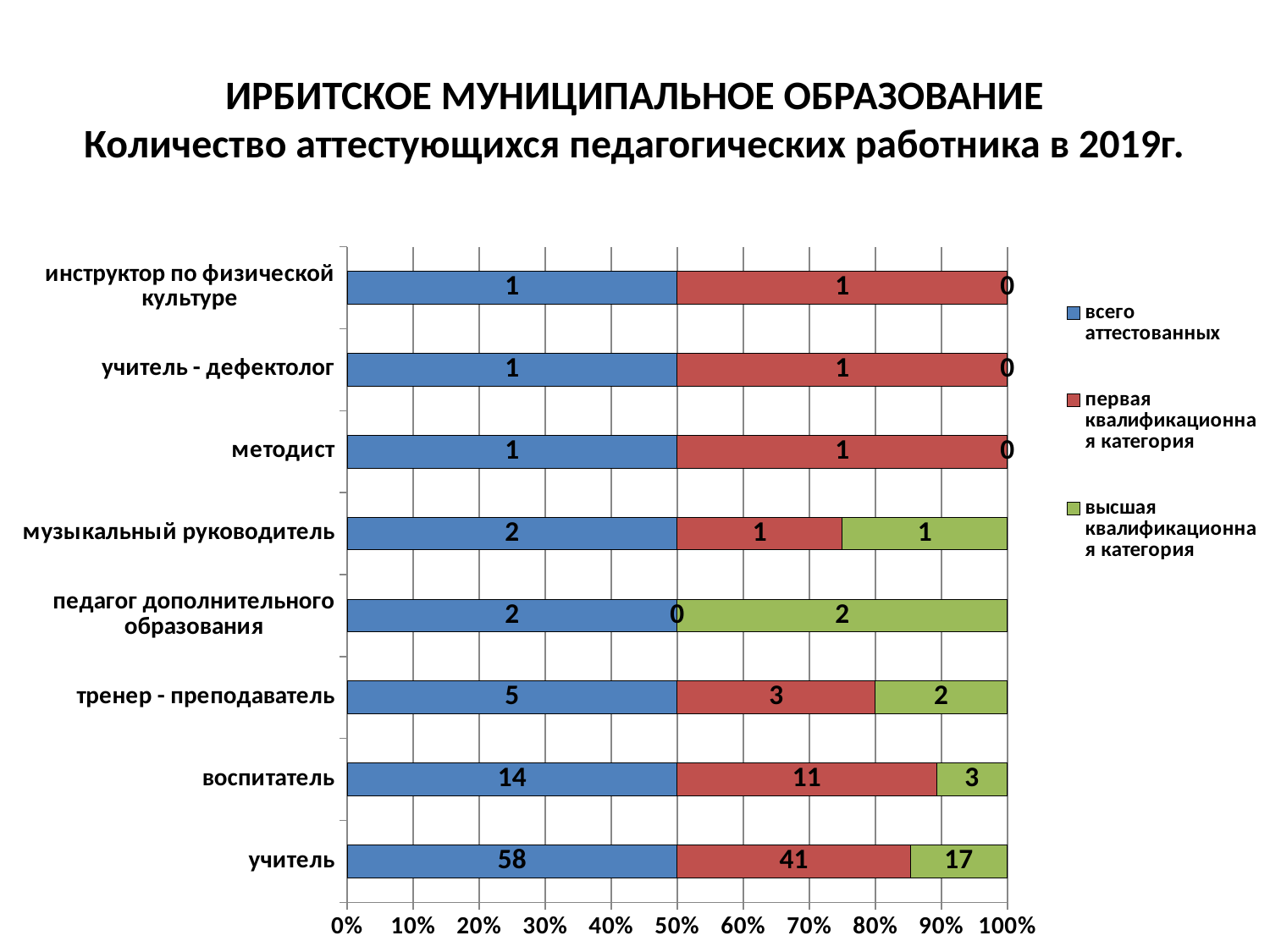
Which is larger for 'воспитатель': 'первая квалификационная категория' or 'высшая квалификационная категория'? первая квалификационная категория What is the value of 'всего аттестованных' for 'учитель'? 58 How many categories (job titles) are shown on the chart? 8 What is the value of 'высшая квалификационная категория' for 'тренер - преподаватель'? 2 What is the difference between 'первая квалификационная категория' and 'высшая квалификационная категория' for 'учитель'? 24 What is the value of 'первая квалификационная категория' for 'педагог дополнительного образования'? 0 How many series does the legend list? 3 Which category has the highest value for 'высшая квалификационная категория'? учитель Which category has the highest value for 'всего аттестованных'? учитель Which colour represents 'всего аттестованных' in the chart? blue What is the value of 'первая квалификационная категория' for 'воспитатель'? 11 What type of chart is shown on the slide? bar chart